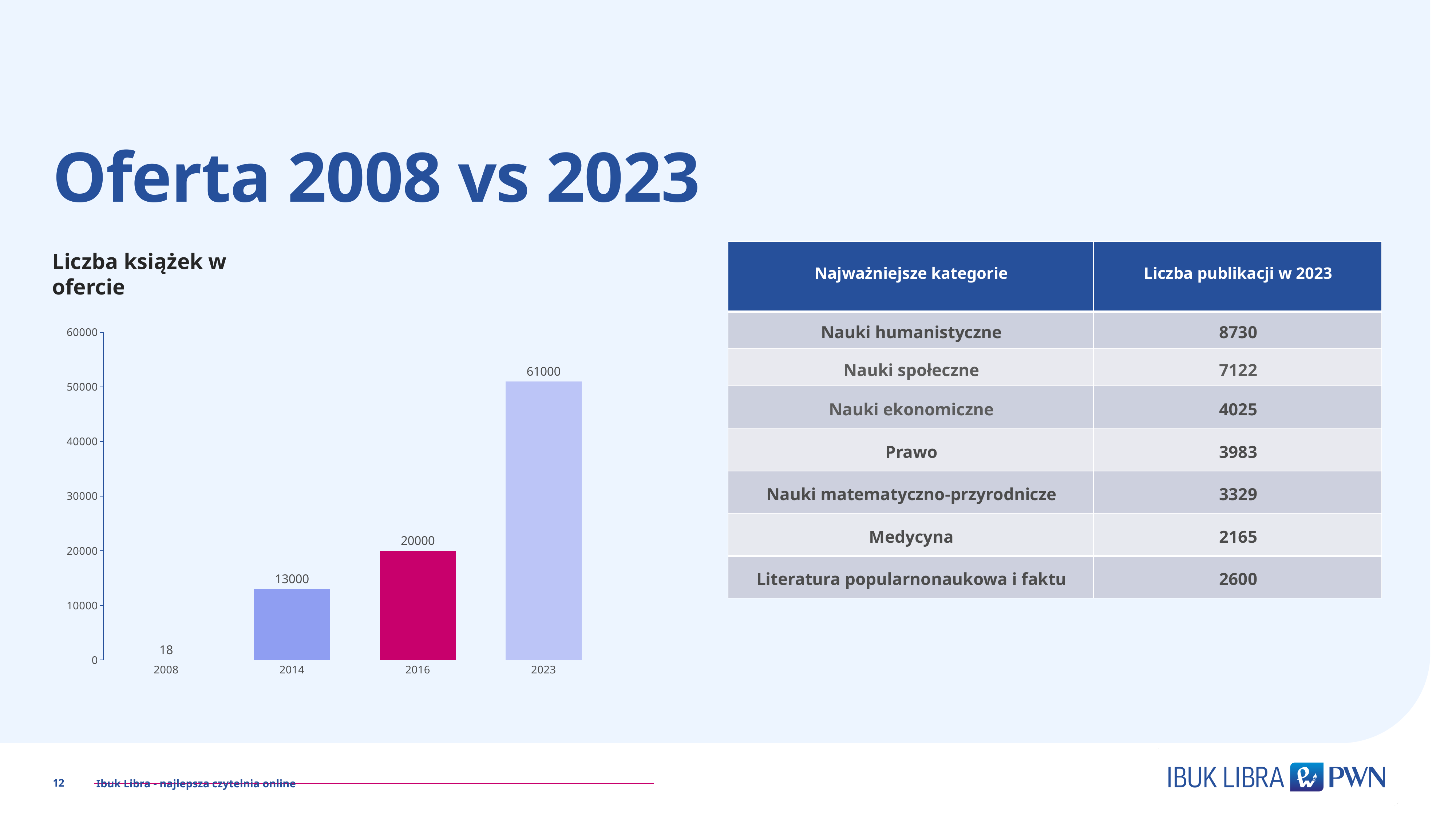
What kind of chart is shown on the slide? bar chart What is the value for 2023 in the chart? 61000 What is the value for 2008 in the chart? 18 Is the value for 2023 greater or less than 50000? greater Which is larger, the value for 2014 or the value for 2016? 2016 Which year has the lowest value in the chart? 2008 What is the value for 2016 in the chart? 20000 Which year has the highest value in the chart? 2023 What is the value for 2014 in the chart? 13000 Do the values rise or fall from 2008 to 2023? rise What is the difference between the values for 2016 and 2014? 7000 How many years are shown on the x axis of the chart? 4